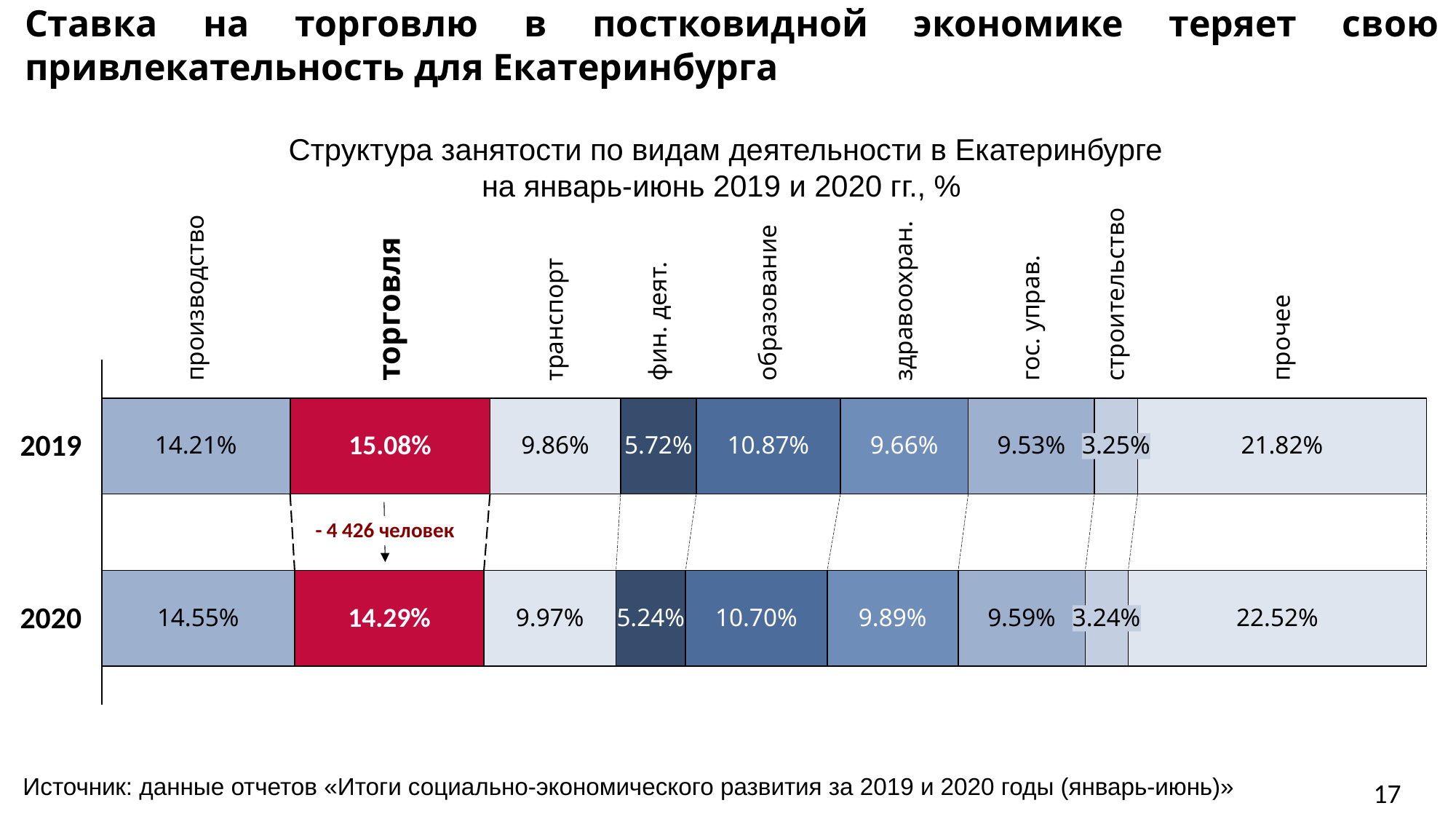
What change in the number of people is annotated between the торговля segments of 2019 and 2020? - 4 426 человек How many activity types (segments) are shown in each bar? 9 Did the share of здравоохран. rise or fall from 2019 to 2020? Rise What share of employment did торговля (trade) have in 2020? 14.29% What is the value for образование in the 2019 bar? 10.87% Which is larger: the share of транспорт in 2019 or in 2020? 2020 What type of chart is shown on the slide? Stacked bar chart What is the value for производство in the 2020 bar? 14.55% Which activity type has the largest share in the 2019 bar? прочее By how many percentage points did the share of торговля fall from 2019 to 2020? 0.79 percentage points What share of employment did торговля (trade) have in Yekaterinburg in 2019? 15.08% Which activity type has the smallest share in the 2020 bar? строительство